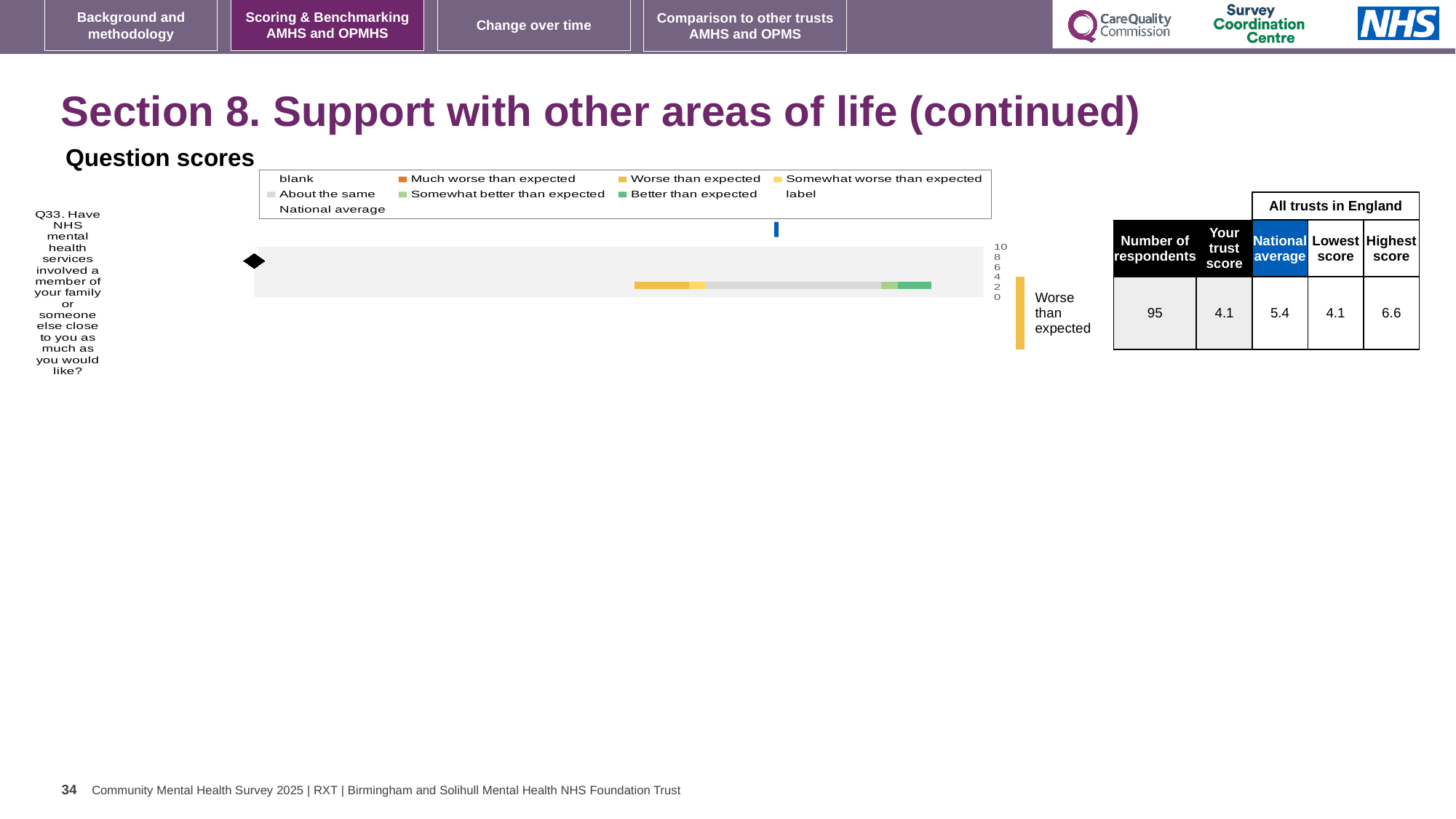
For Q33, which is larger: your trust score or the national average? national average In the table beside the Question scores chart, what is the lowest score among all trusts in England for Q33? 4.1 In the table beside the Question scores chart, what is the highest score among all trusts in England for Q33? 6.6 In the table beside the Question scores chart, what is the national average for Q33? 5.4 How many questions (categories) are plotted in the Question scores chart? 1 What kind of chart is shown under 'Question scores'? bar chart In the table beside the Question scores chart, what is the number of respondents for Q33? 95 Which question number is plotted in the Question scores chart? Q33 For Q33, what is the difference between the national average and your trust score? 1.3 What rating label is shown to the right of the Q33 bar in the Question scores chart? Worse than expected In the table beside the Question scores chart, what is 'Your trust score' for Q33? 4.1 For Q33, what is the difference between the highest score and the lowest score among all trusts in England? 2.5